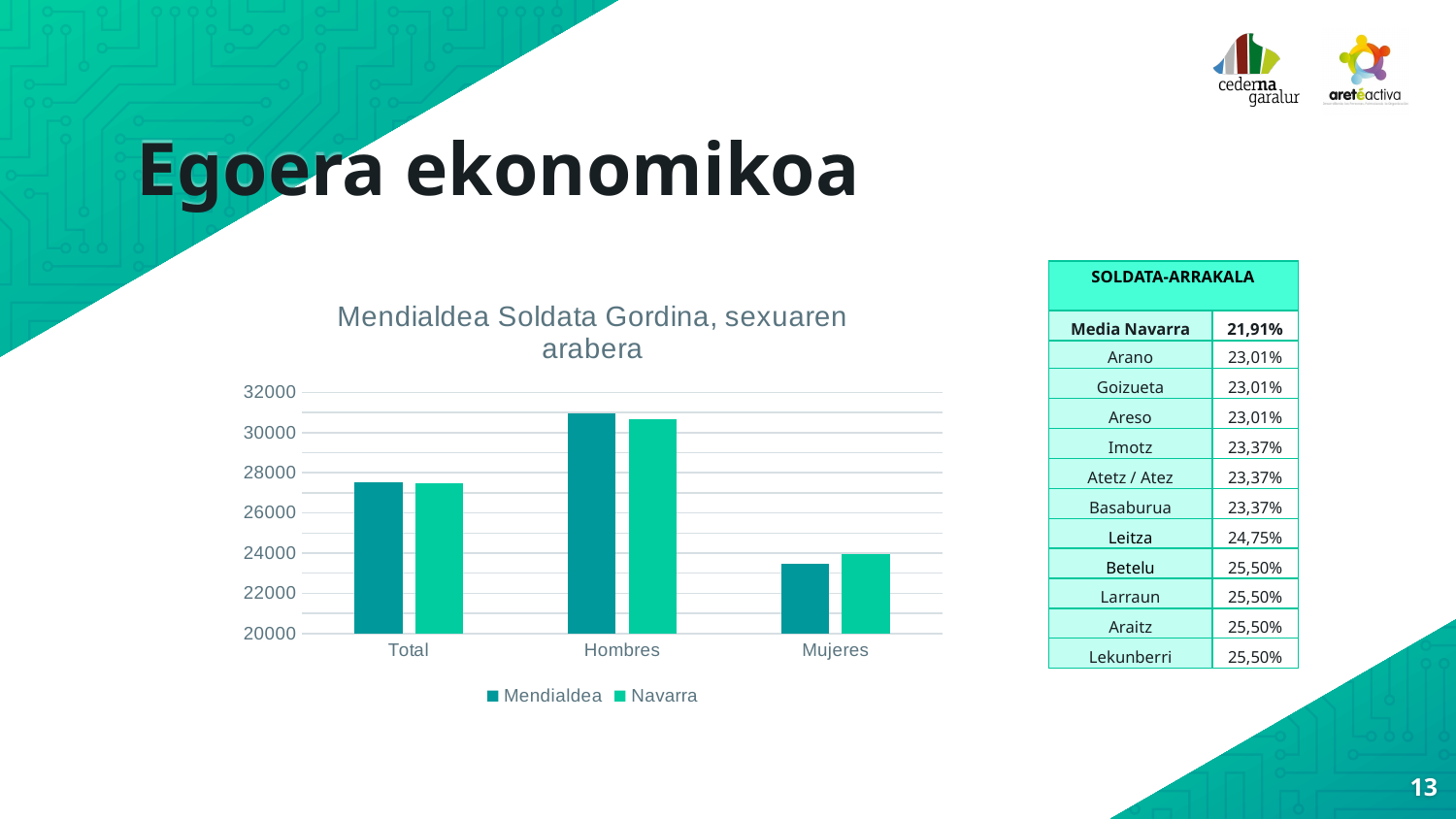
Which category has the lowest Navarra value? Mujeres Is the Mendialdea value for Mujeres greater or less than 24000? less Is the Navarra value for Total greater or less than 28000? less For the Mendialdea series, which is larger: the value for Hombres or the value for Mujeres? Hombres What is the title of the chart? Mendialdea Soldata Gordina, sexuaren arabera Is the Mendialdea value for Hombres greater or less than 30000? greater Which category has the highest Mendialdea value? Hombres How many series does the chart's legend list? 2 How many categories are shown on the x axis of the chart? 3 What kind of chart is shown on the slide? bar chart Which series are listed in the chart's legend? Mendialdea and Navarra